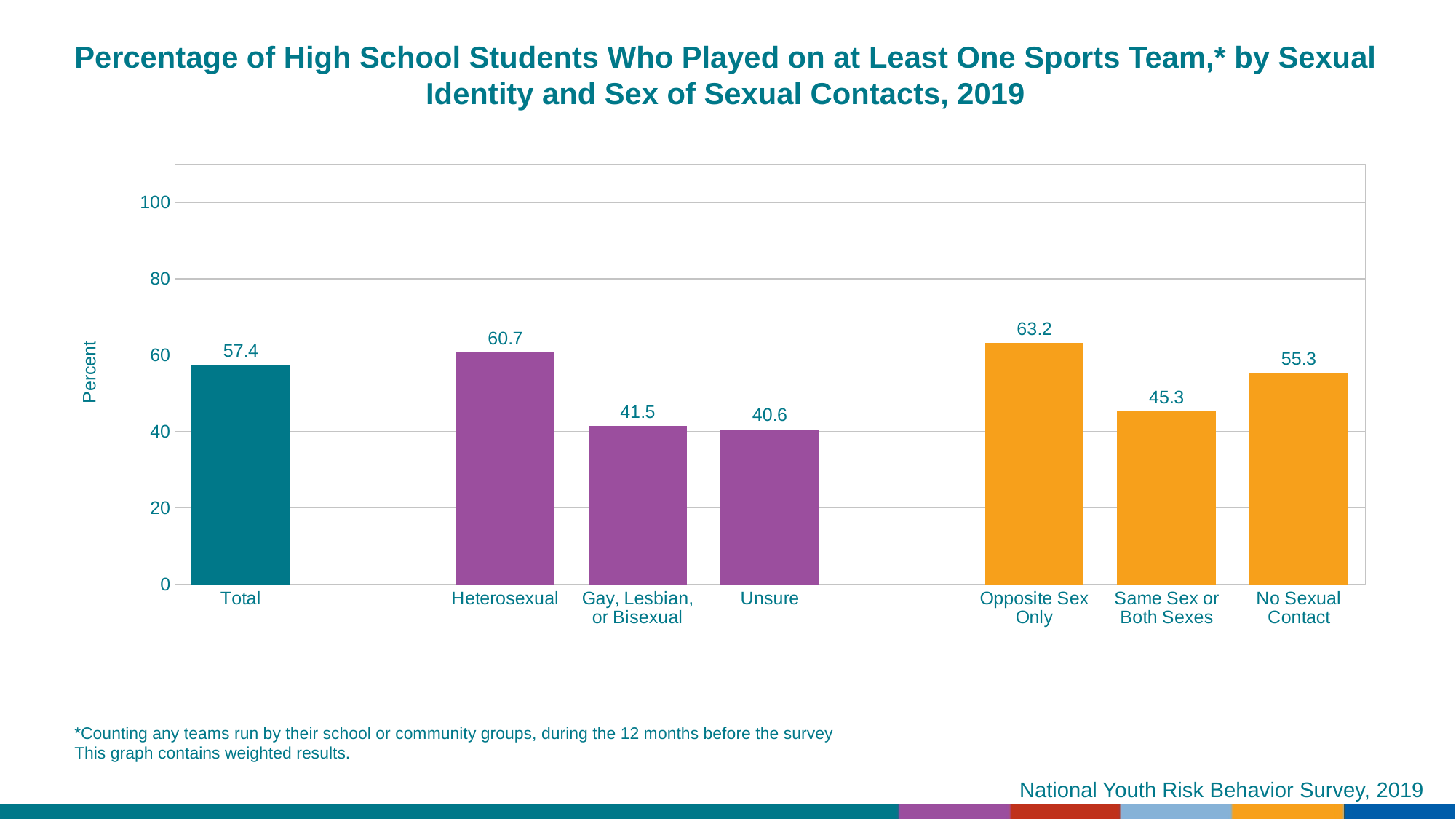
What is the value for Heterosexual students? 60.7 What is the value for Gay, Lesbian, or Bisexual students? 41.5 What is the label of the y axis? Percent Which category has the highest value? Opposite Sex Only What is the value for students with No Sexual Contact? 55.3 What kind of chart is shown on the slide? bar chart What is the value for Total? 57.4 Is the value for Same Sex or Both Sexes greater or less than 40? greater How many categories are shown in the chart? 7 Which is larger, the value for Heterosexual or the value for Total? Heterosexual What is the difference between the values for Opposite Sex Only and Same Sex or Both Sexes? 17.9 Which category has the lowest value? Unsure